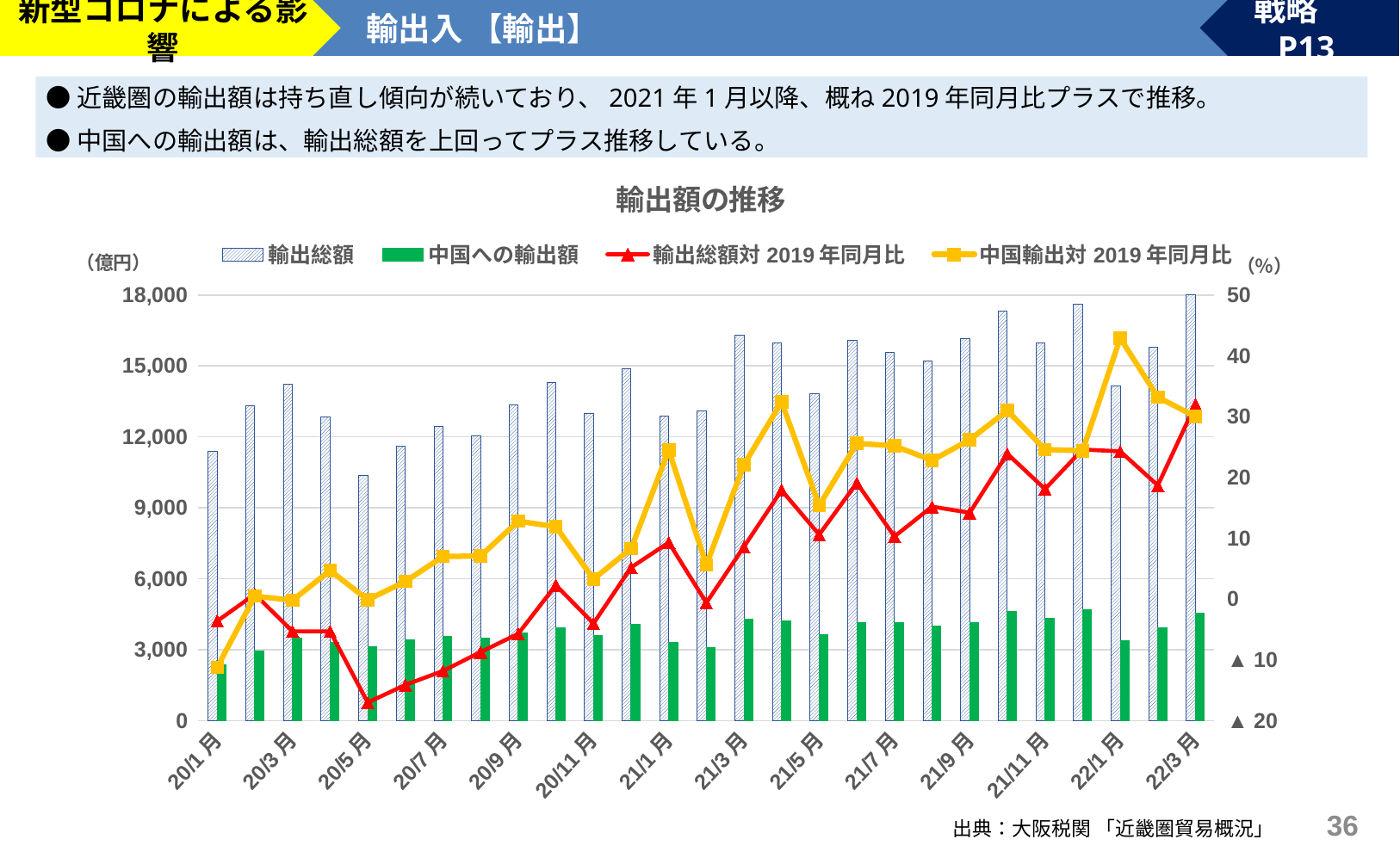
What kind of chart is shown on the slide? A combined bar and line chart Which is larger, the 輸出総額 for 20/3月 or for 20/5月? 20/3月 Which month has the lowest value for 輸出総額対2019年同月比? 20/5月 Is the value for 輸出総額 in 20/5月 greater or less than 12,000? less Is the value for 輸出総額 in 22/1月 greater or less than 12,000? greater How many series does the chart legend list? 4 What unit is shown on the left vertical axis of the chart? 億円 What is the title of the chart? 輸出額の推移 Is the value for 中国輸出対2019年同月比 in 22/1月 greater or less than 40? greater In 22/1月, which is larger, 中国輸出対2019年同月比 or 輸出総額対2019年同月比? 中国輸出対2019年同月比 Which month has the lowest value for 輸出総額? 20/5月 Which month has the highest value for 中国輸出対2019年同月比? 22/1月